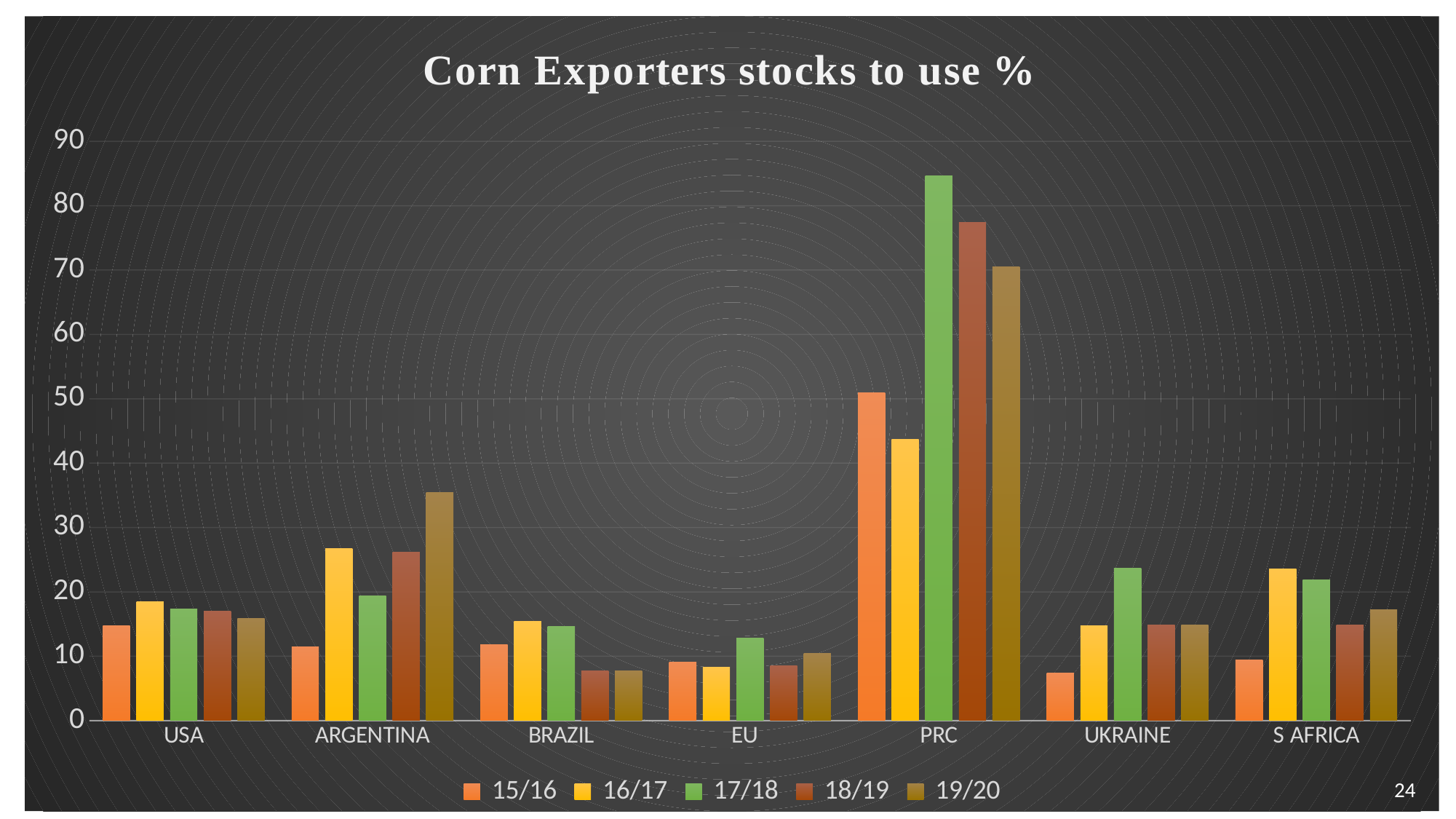
What kind of chart is shown on the slide? bar chart How many series does the legend list? 5 For BRAZIL, which is larger: the 16/17 value or the 18/19 value? 16/17 Is the 19/20 value for ARGENTINA greater or less than 30? greater Is the 17/18 value for PRC greater or less than 80? greater For PRC, which is larger: the 15/16 value or the 16/17 value? 15/16 How many countries/regions are shown on the x axis? 7 For ARGENTINA, which series has the highest value? 19/20 Which country has the highest 17/18 stocks to use %? PRC Is the 19/20 value for PRC greater or less than 60? greater What is the title of the chart? Corn Exporters stocks to use %